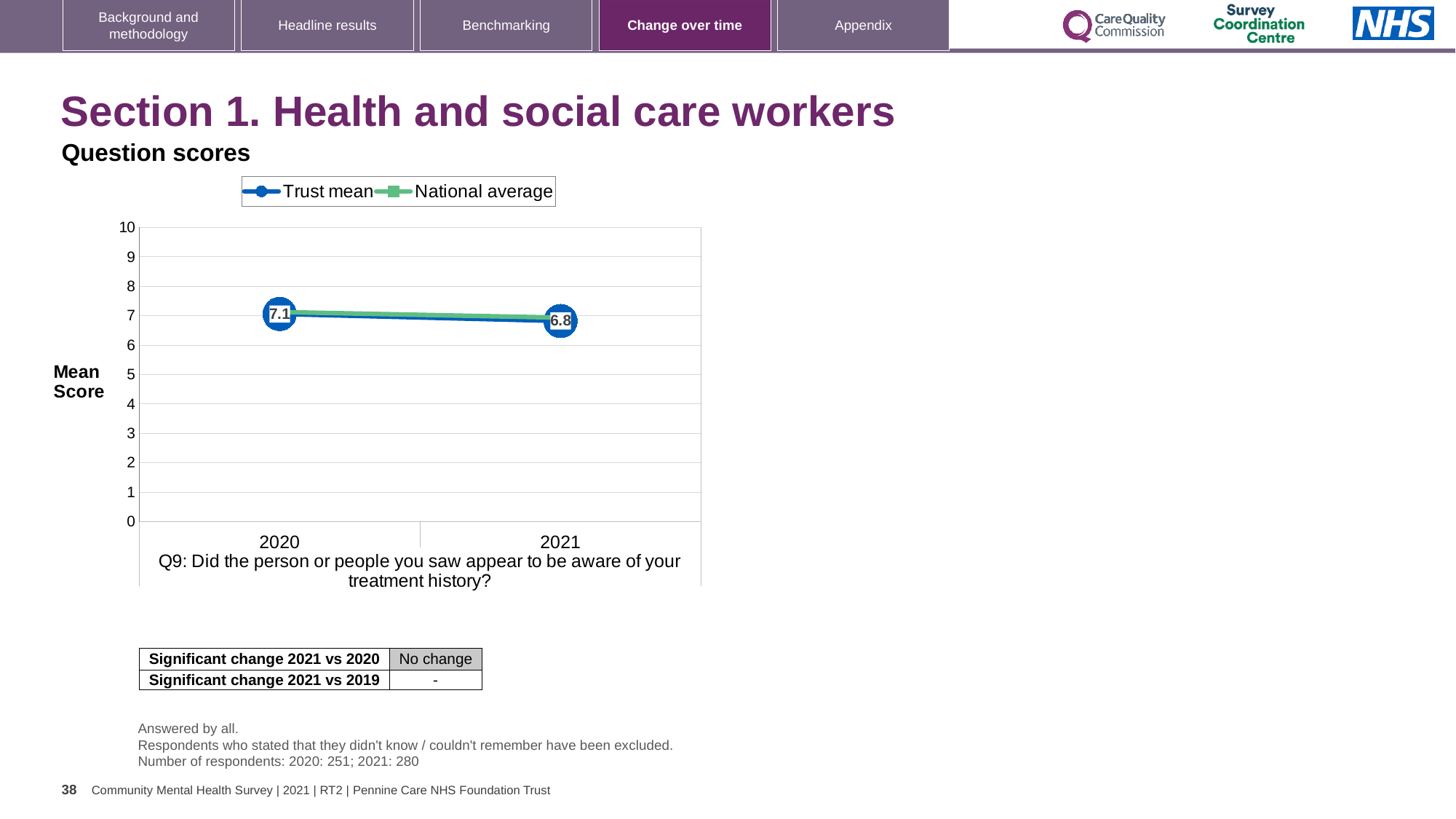
By how much did the Trust mean score change from 2020 to 2021? 0.3 What is the label on the y axis of the chart? Mean Score In which year is the Trust mean score lowest? 2021 Is the National average value for 2021 greater or less than 5? greater In which year is the Trust mean score higher, 2020 or 2021? 2020 What are the two series named in the legend? Trust mean and National average Does the Trust mean score rise or fall from 2020 to 2021? fall What is the Trust mean score for 2021? 6.8 How many series does the legend list? 2 What is the Trust mean score for 2020? 7.1 How many years are plotted on the x axis? 2 What kind of chart is shown on the slide? line chart